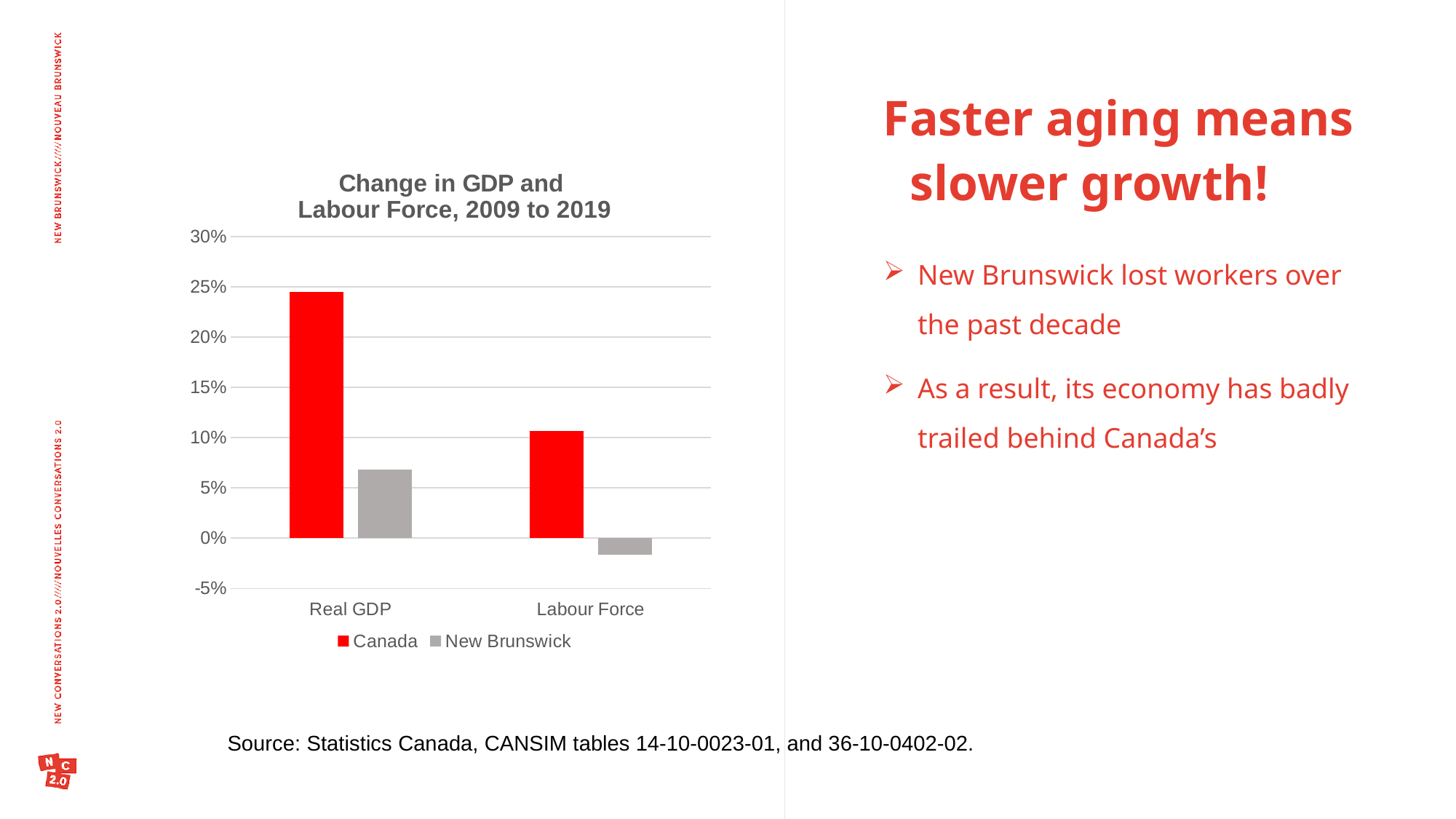
Is the value for Canada in Real GDP greater or less than 20%? greater Which bar is the lowest in the chart? New Brunswick, Labour Force What kind of chart is shown on the slide? bar chart How many series does the chart's legend list? 2 Is the value for New Brunswick in Labour Force greater or less than 0%? less Which bar is the highest in the chart? Canada, Real GDP How many categories are shown on the x axis of the chart? 2 Is the value for Canada in Labour Force greater or less than 5%? greater For Labour Force, which is larger: the value for Canada or the value for New Brunswick? Canada Which series is shown in red in the chart? Canada What is the title of the chart? Change in GDP and Labour Force, 2009 to 2019